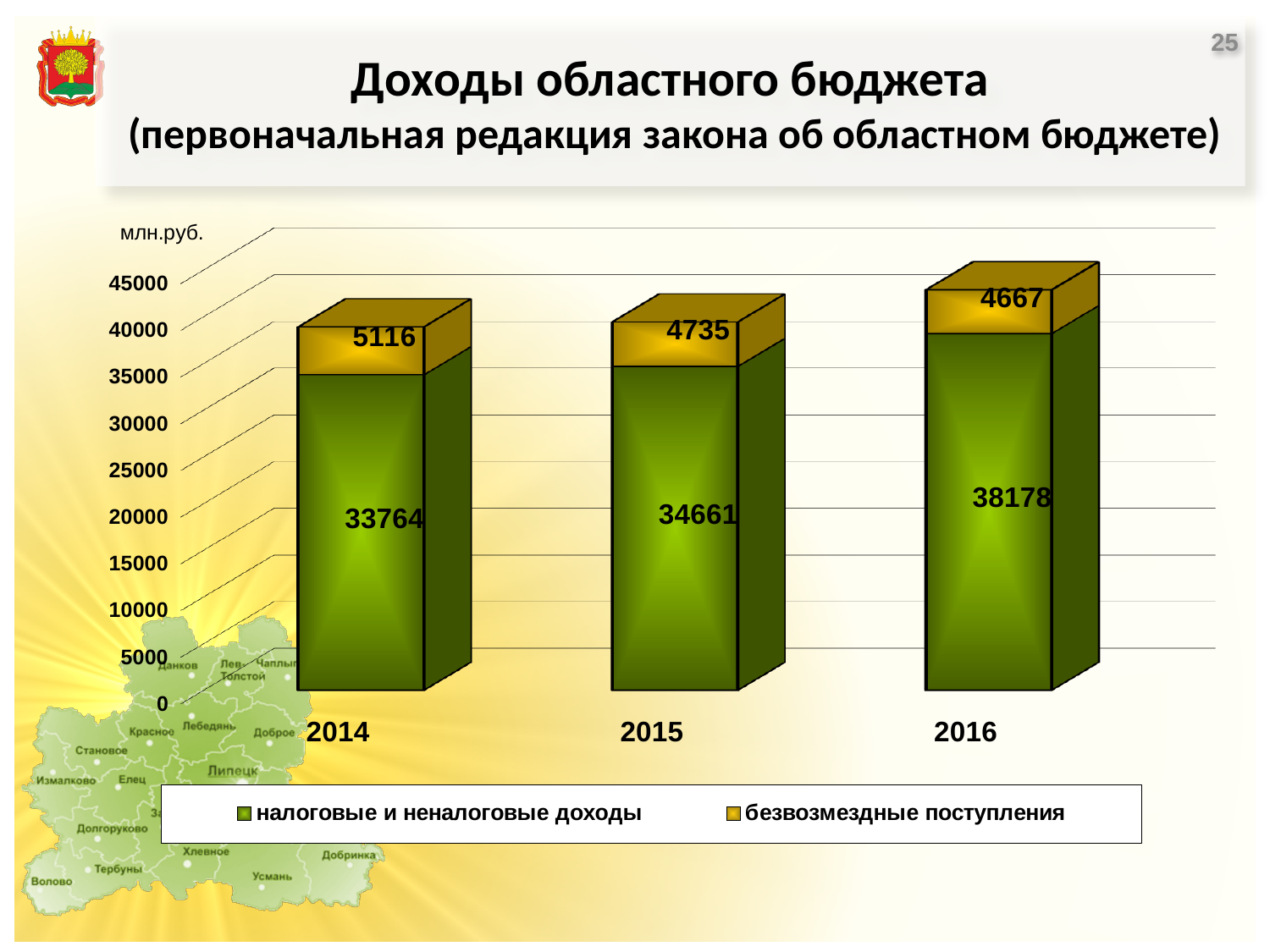
What is the difference between налоговые и неналоговые доходы in 2016 and in 2014? 4414 How many years are shown on the x axis? 3 What is the value of налоговые и неналоговые доходы for 2014? 33764 What is the value of безвозмездные поступления for 2016? 4667 How many series does the legend list? 2 What is the total of the stacked bar for 2014? 38880 What is the value of безвозмездные поступления for 2015? 4735 What is the total of the stacked bar for 2016? 42845 Do the values for налоговые и неналоговые доходы rise or fall from 2014 to 2016? rise Which year has the highest value for налоговые и неналоговые доходы? 2016 Which year has the lowest value for безвозмездные поступления? 2016 Which is larger: безвозмездные поступления in 2014 or in 2015? 2014